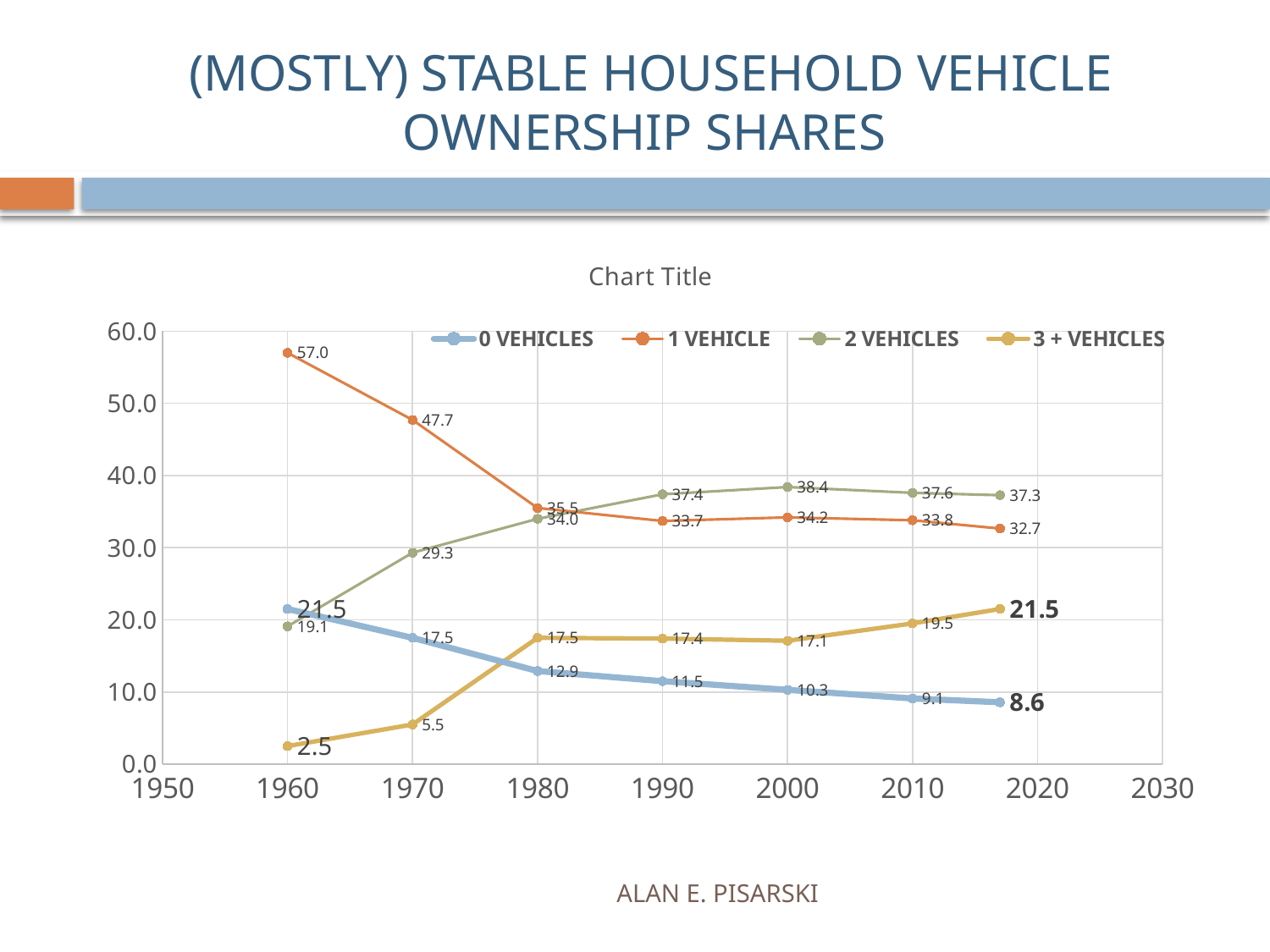
What is the value for 1 VEHICLE in 1960? 57.0 Which series has the lowest value in 2010? 0 VEHICLES What is the value for 3 + VEHICLES in 1970? 5.5 Which is larger in 1990, the value for 2 VEHICLES or the value for 1 VEHICLE? 2 VEHICLES How many data points are plotted for the 3 + VEHICLES series? 7 Does the 0 VEHICLES series rise or fall from 1960 to its final point? fall Which series has the highest value in 1960? 1 VEHICLE What is the difference between the 1 VEHICLE values in 1960 and 1970? 9.3 What is the value for 0 VEHICLES in 1980? 12.9 What is the value for 2 VEHICLES in 2000? 38.4 How many series does the legend list? 4 What kind of chart is shown on the slide? line chart